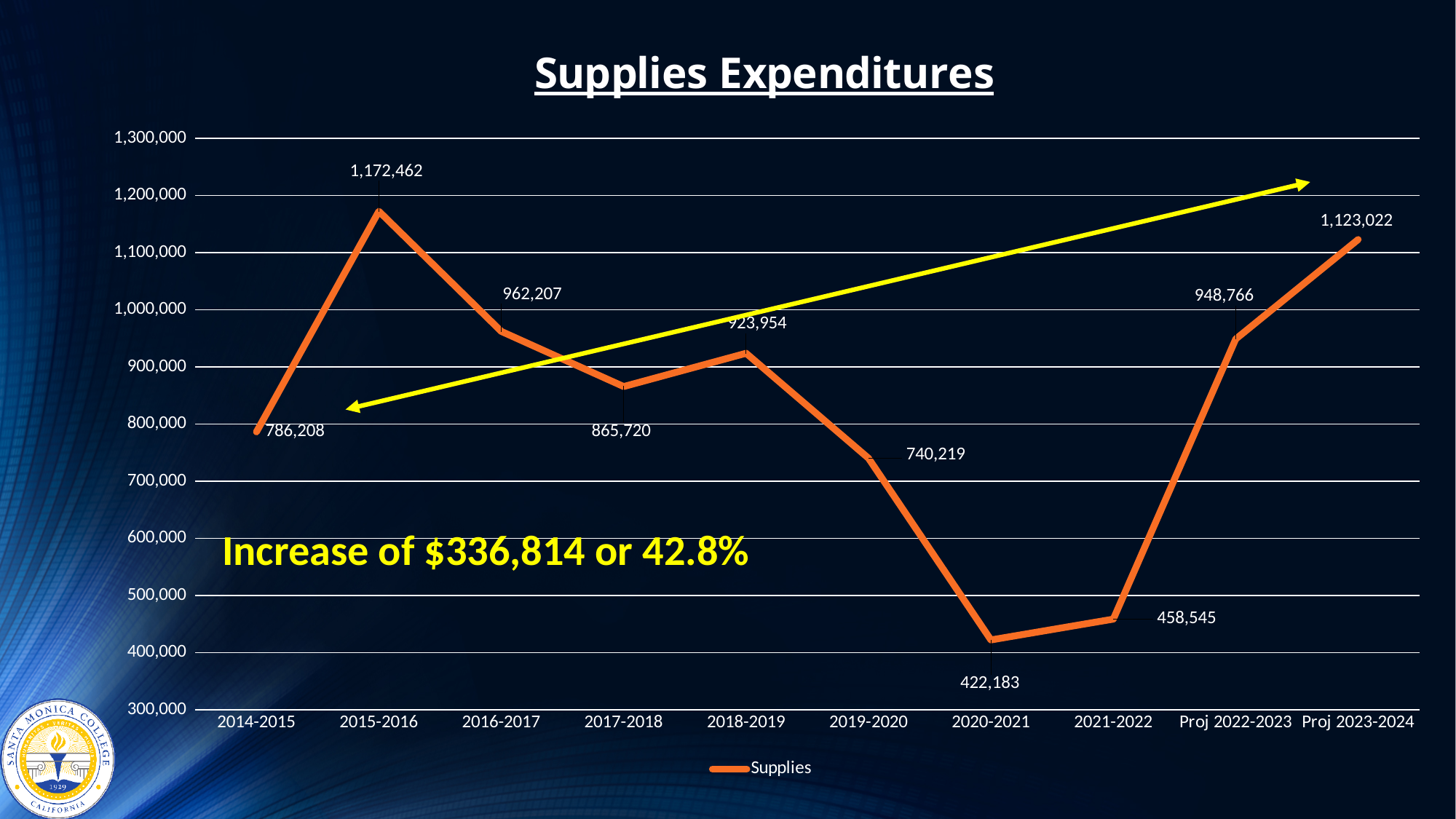
What is the difference between the values for Proj 2023-2024 and Proj 2022-2023? 174,256 What is the title of the chart? Supplies Expenditures Which year has the lowest supplies expenditure? 2020-2021 How many years are shown on the x axis? 10 Which is larger, the value for 2016-2017 or the value for 2018-2019? 2016-2017 What is the difference between the values for 2015-2016 and 2014-2015? 386,254 Which year has the highest supplies expenditure? 2015-2016 What is the value for Proj 2023-2024? 1,123,022 Is the value for 2019-2020 greater or less than 800,000? less What kind of chart is this? line chart What is the value for 2020-2021? 422,183 What is the value for 2015-2016? 1,172,462